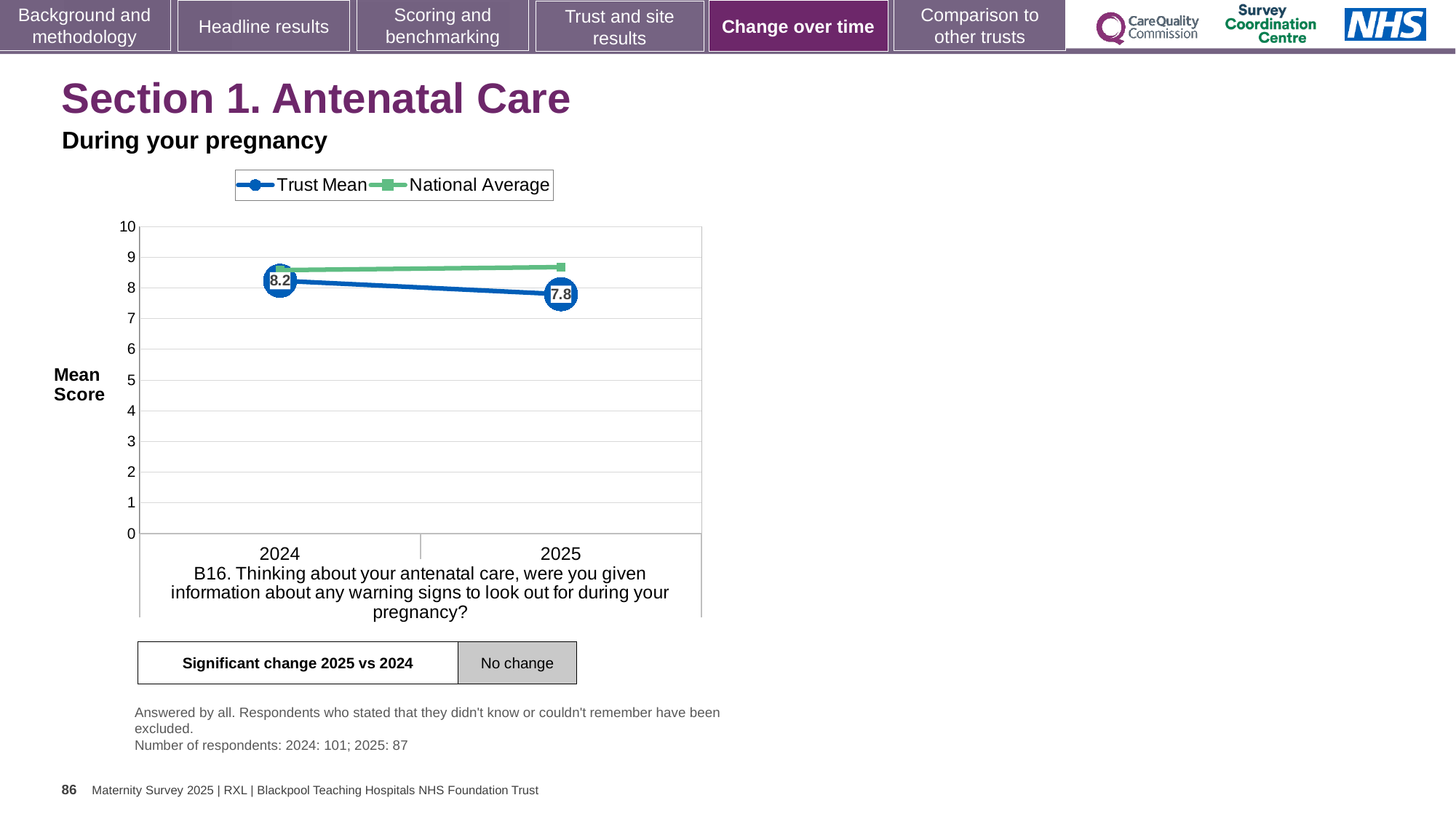
What is the label of the y axis of the chart? Mean Score Which year has the higher Trust Mean, 2024 or 2025? 2024 Does the Trust Mean rise or fall from 2024 to 2025? fall What is the Trust Mean value for 2025? 7.8 Is the National Average value for 2025 greater or less than 8? greater By how much did the Trust Mean change from 2024 to 2025? 0.4 How many series does the chart legend list? 2 How many years are shown on the x axis of the chart? 2 What kind of chart is shown on the slide? line chart Is the Trust Mean value for 2025 greater or less than 8? less In 2025, which series is higher, Trust Mean or National Average? National Average What is the Trust Mean value for 2024? 8.2